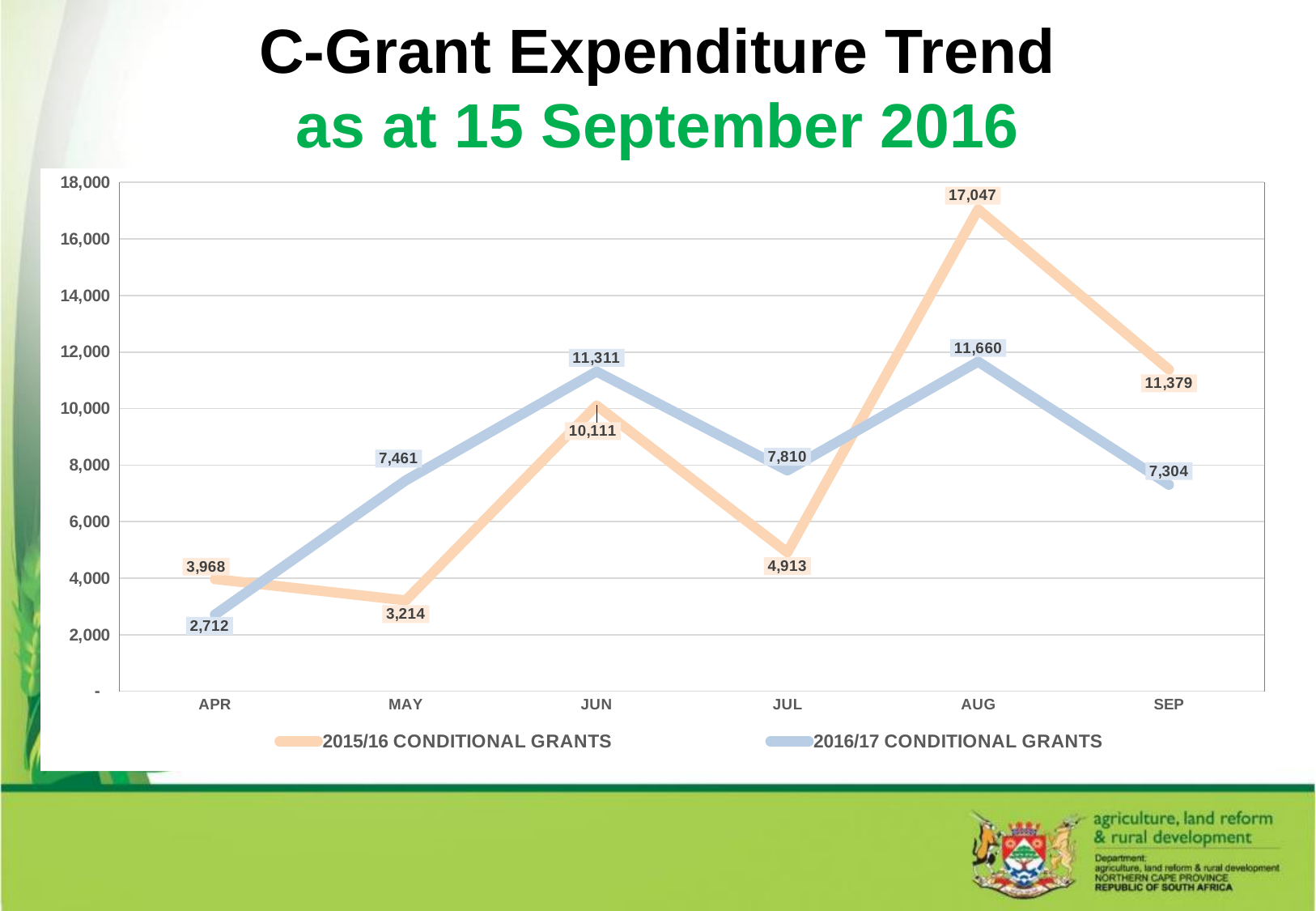
How many series does the legend list? 2 Which colour represents the 2015/16 conditional grants series? Orange In which month was the 2016/17 conditional grants expenditure lowest? APR What was the 2016/17 conditional grants expenditure in MAY? 7,461 What type of chart is shown on the slide? Line chart Did the 2016/17 conditional grants expenditure rise or fall from AUG to SEP? Fall How many months are shown on the x axis? 6 Which series had the higher expenditure in JUN, 2015/16 or 2016/17 conditional grants? 2016/17 CONDITIONAL GRANTS What was the 2016/17 conditional grants expenditure in SEP? 7,304 In which month was the 2015/16 conditional grants expenditure highest? AUG What is the difference between the 2015/16 and 2016/17 conditional grants expenditure in AUG? 5,387 What was the 2015/16 conditional grants expenditure in AUG? 17,047